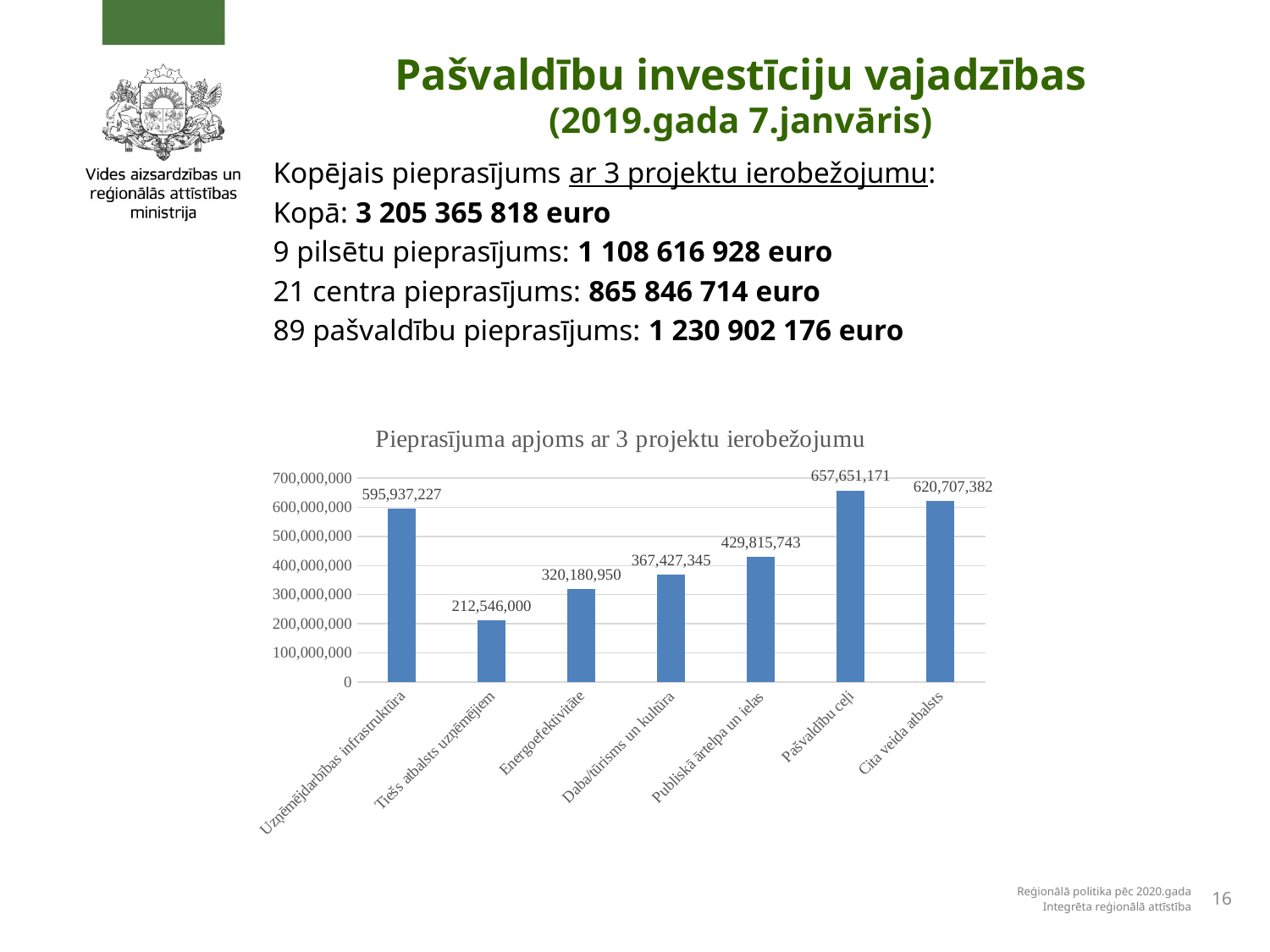
What is the difference between the values for Uzņēmējdarbības infrastruktūra and Tiešs atbalsts uzņēmējiem? 383,391,227 What is the value for Energoefektivitāte? 320,180,950 What is the difference between the values for Pašvaldību ceļi and Cita veida atbalsts? 36,943,789 What is the value for Publiskā ārtelpa un ielas? 429,815,743 Is the value for Cita veida atbalsts greater or less than 600,000,000? greater How many categories are shown in the chart? 7 Which category has the highest value? Pašvaldību ceļi What kind of chart is shown on the slide? bar chart What is the value for Pašvaldību ceļi? 657,651,171 What is the value for Tiešs atbalsts uzņēmējiem? 212,546,000 Which is larger, the value for Daba/tūrisms un kultūra or the value for Publiskā ārtelpa un ielas? Publiskā ārtelpa un ielas Which category has the lowest value? Tiešs atbalsts uzņēmējiem